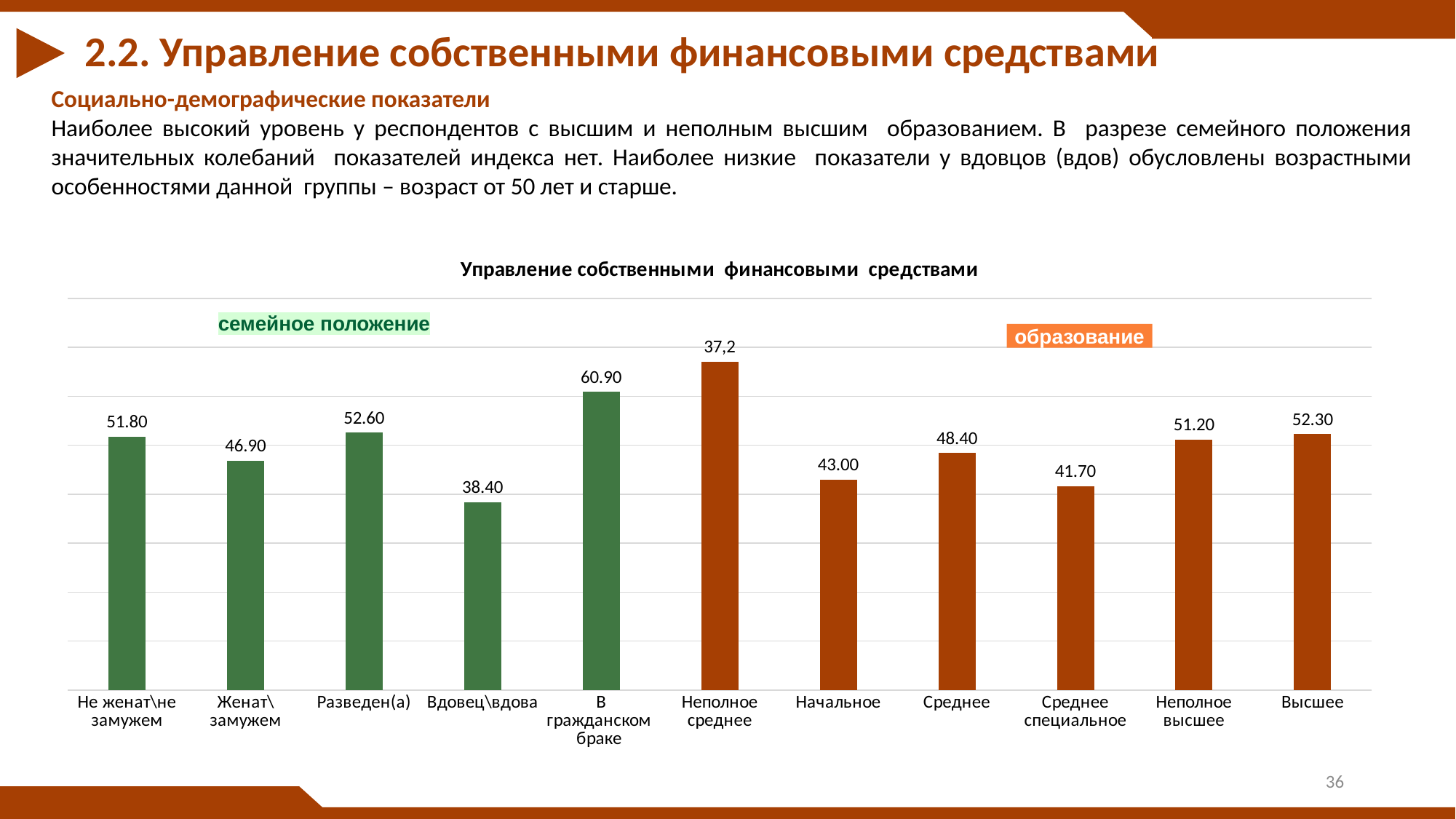
Among the family status (семейное положение) categories, which has the lowest value? Вдовец\вдова Among the family status (семейное положение) categories, which has the highest value? В гражданском браке What is the value for В гражданском браке? 60.90 What is the value for Вдовец\вдова? 38.40 What is the title of the chart? Управление собственными финансовыми средствами What kind of chart is shown on the slide? Bar chart What is the difference between the values for Высшее and Начальное? 9.30 What is the value for Среднее специальное? 41.70 What is the difference between the values for Разведен(а) and Женат\замужем? 5.70 What is the value for Высшее? 52.30 How many categories are shown on the x axis of the chart? 11 Which is larger, the value for Среднее or the value for Среднее специальное? Среднее